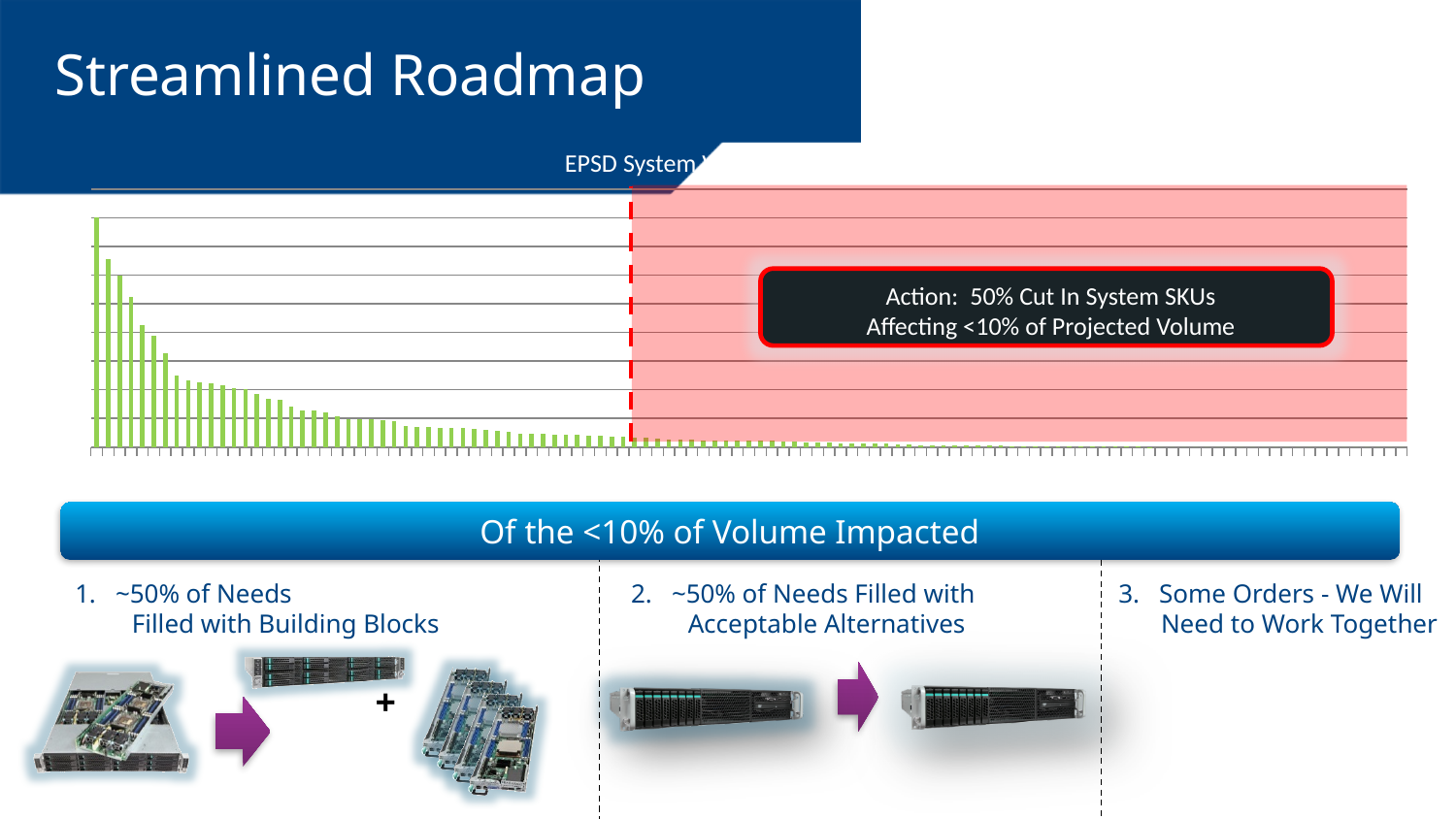
What kind of chart is shown on the slide? bar chart What colour are the bars in the chart? green What action does the annotation box on the chart describe? 50% Cut In System SKUs Affecting <10% of Projected Volume Do the bar values rise or fall moving from left to right along the x axis? fall Where is the tallest bar in the chart located? at the far left